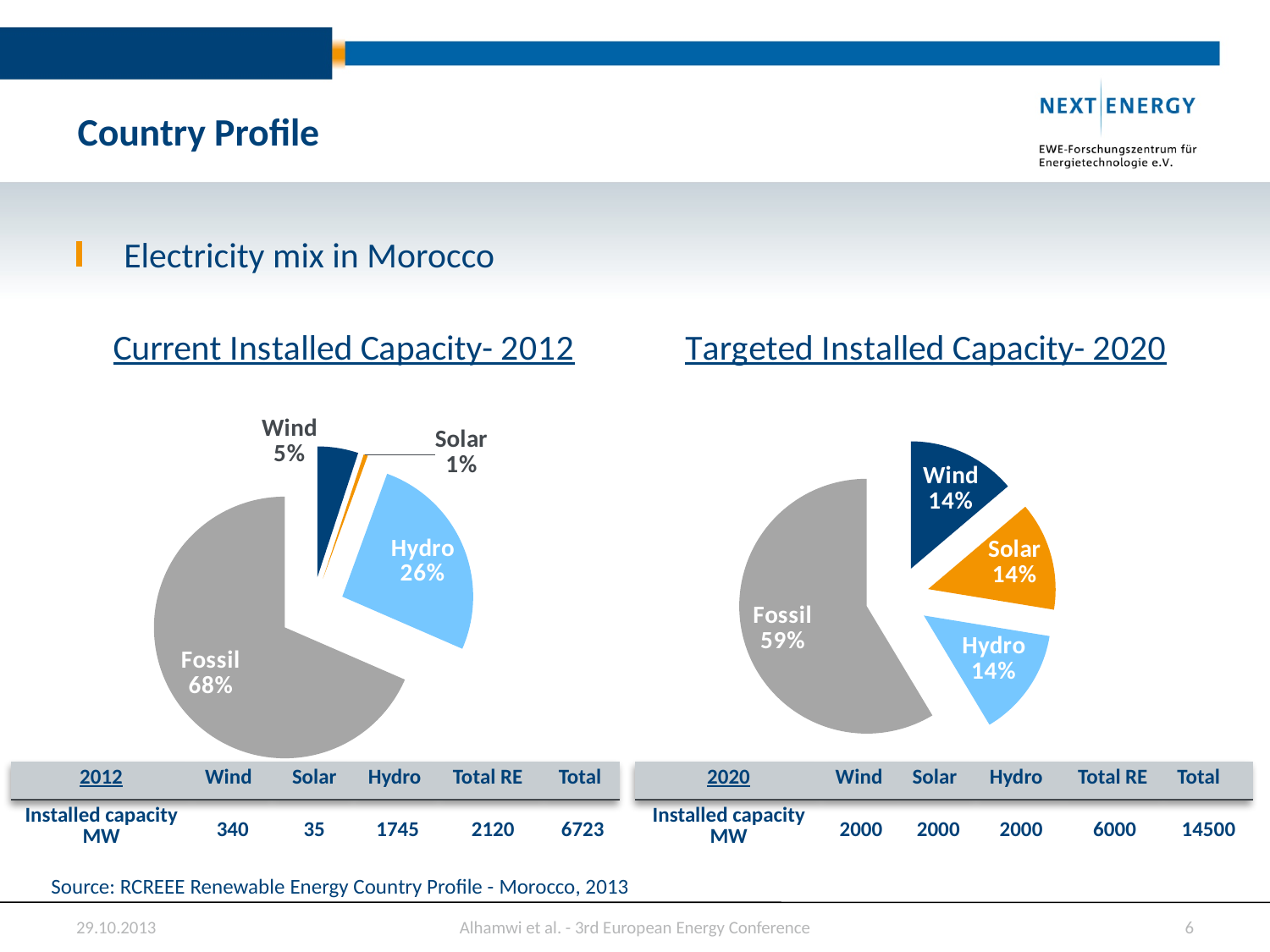
In the Targeted Installed Capacity- 2020 chart, what share does Solar have? 14% In the Current Installed Capacity- 2012 chart, what share does Hydro have? 26% In the Current Installed Capacity- 2012 chart, what share does Fossil have? 68% What kind of chart is the Current Installed Capacity- 2012 chart? Pie chart In the Current Installed Capacity- 2012 chart, which category has the smallest slice? Solar In the Targeted Installed Capacity- 2020 chart, which category has the largest slice? Fossil In the Targeted Installed Capacity- 2020 chart, what colour is the Solar slice? Orange In the Current Installed Capacity- 2012 chart, what is the difference in percentage points between Fossil and Hydro? 42 How many slices does the Targeted Installed Capacity- 2020 chart have? 4 In the Current Installed Capacity- 2012 chart, which category has the largest slice? Fossil In the Current Installed Capacity- 2012 chart, which is larger, Wind or Solar? Wind